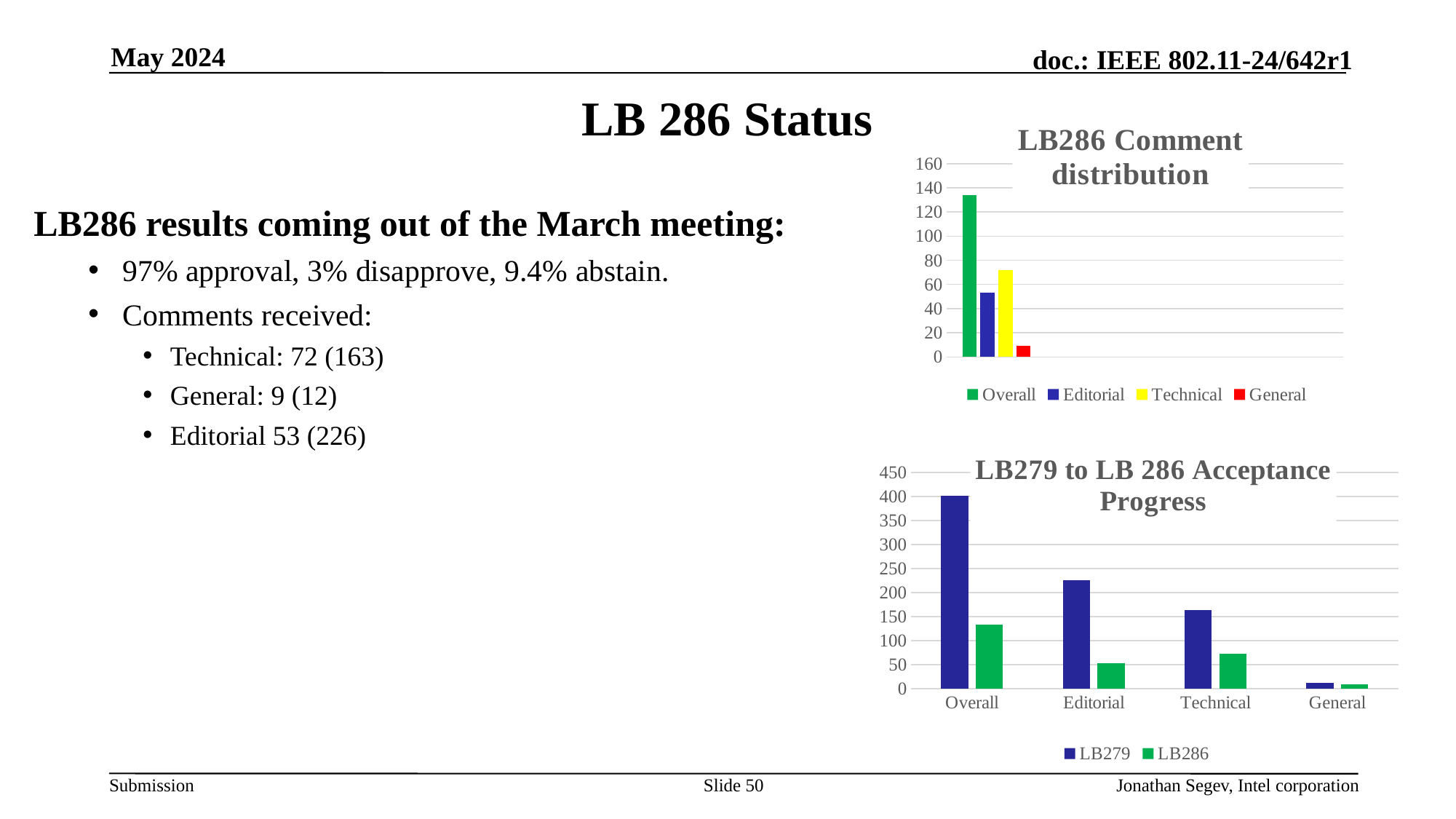
In the "LB279 to LB 286 Acceptance Progress" chart, is the LB279 value for Editorial greater or less than 200? greater In the "LB286 Comment distribution" chart, which is larger, Technical or Editorial? Technical In the "LB286 Comment distribution" chart, which series has the highest value? Overall What kind of chart is the "LB286 Comment distribution" chart? bar chart In the "LB279 to LB 286 Acceptance Progress" chart, which series has the larger value for Technical, LB279 or LB286? LB279 In the "LB286 Comment distribution" chart, is the value for Overall greater or less than 120? greater How many series does the legend of the "LB286 Comment distribution" chart list? 4 In the "LB279 to LB 286 Acceptance Progress" chart, what colour represents the LB286 series? green In the "LB286 Comment distribution" chart, which series has the lowest value? General In the "LB279 to LB 286 Acceptance Progress" chart, which category has the highest LB279 value? Overall How many categories are shown on the x axis of the "LB279 to LB 286 Acceptance Progress" chart? 4 How many series does the legend of the "LB279 to LB 286 Acceptance Progress" chart list? 2